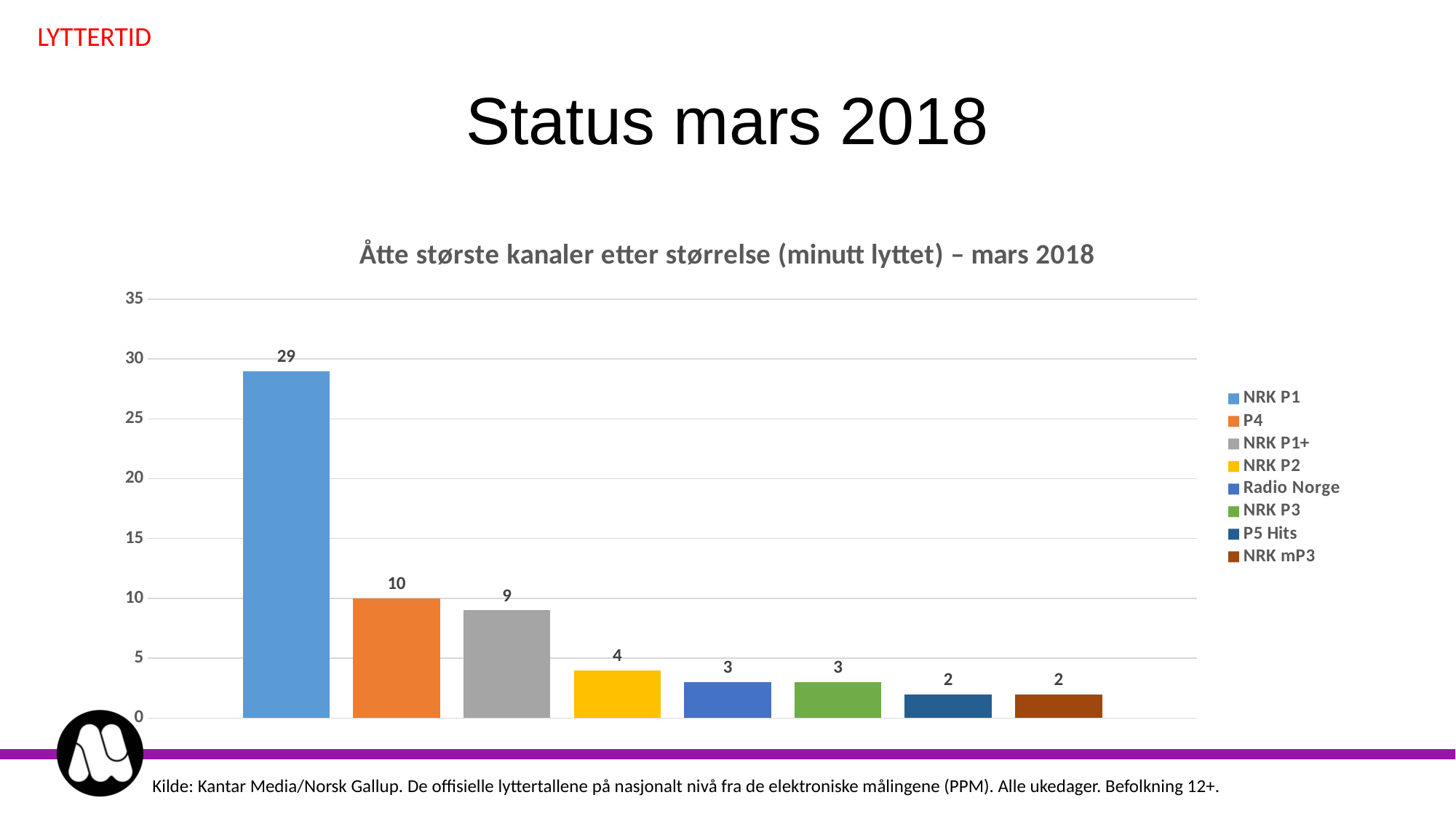
Which channel has the highest value? NRK P1 How many bars are shown in the chart? 8 How many entries does the legend list? 8 What is the title of the chart? Åtte største kanaler etter størrelse (minutt lyttet) – mars 2018 What kind of chart is shown on the slide? Bar chart What is the value for NRK P1? 29 What is the value for NRK P2? 4 Which is larger, the value for P4 or the value for NRK P1+? P4 What is the difference between the values for NRK P1 and P4? 19 What is the value for Radio Norge? 3 What is the difference between the values for NRK P1+ and NRK P3? 6 What is the value for P4? 10